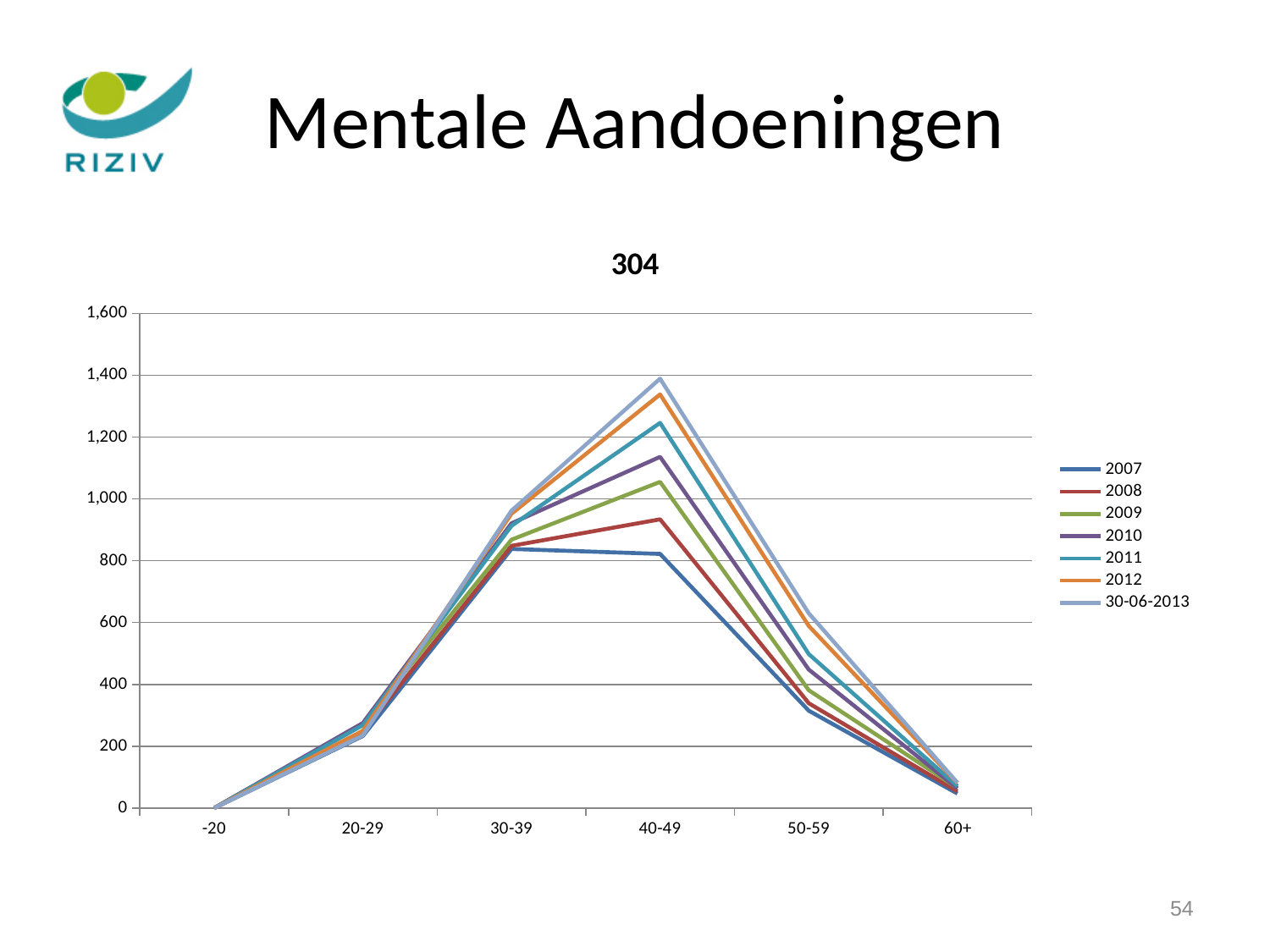
Is the value for 30-06-2013 at 40-49 greater or less than 1,200? greater Which series has the lowest value at 40-49? 2007 At 40-49, which is larger: the value for 2012 or the value for 2007? 2012 Which series is listed last in the legend? 30-06-2013 Which series has the highest value at 40-49? 30-06-2013 For the 2012 series, which age category has the lowest value? -20 How many series does the legend list? 7 How many age categories are shown on the x axis? 6 What kind of chart is shown on the slide? line chart Is the value for 2007 at 50-59 greater or less than 400? less What is the title of the chart? 304 For the 30-06-2013 series, which age category has the highest value? 40-49